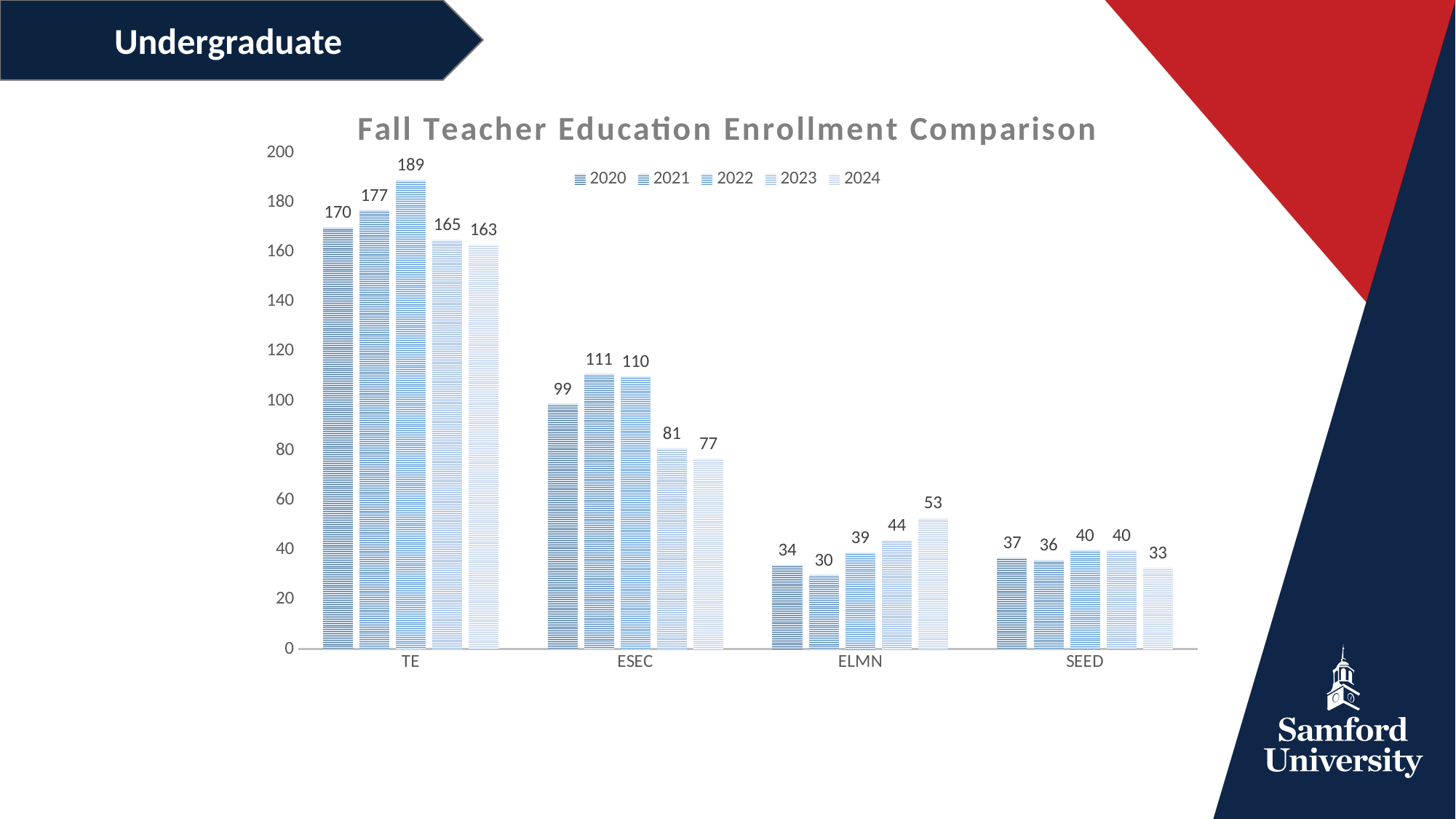
Do the values for ELMN rise or fall from 2021 to 2024? rise What is the 2021 value for ELMN? 30 What is the title of the chart? Fall Teacher Education Enrollment Comparison Which is larger, the 2020 value for ESEC or the 2023 value for ESEC? 2020 What kind of chart is shown? bar chart What is the difference between the 2022 and 2024 values for TE? 26 How many series does the legend list? 5 What is the 2022 value for TE? 189 What is the 2024 value for ESEC? 77 Which year has the highest value for ELMN? 2024 How many categories are shown on the x axis? 4 Which year has the lowest value for SEED? 2024